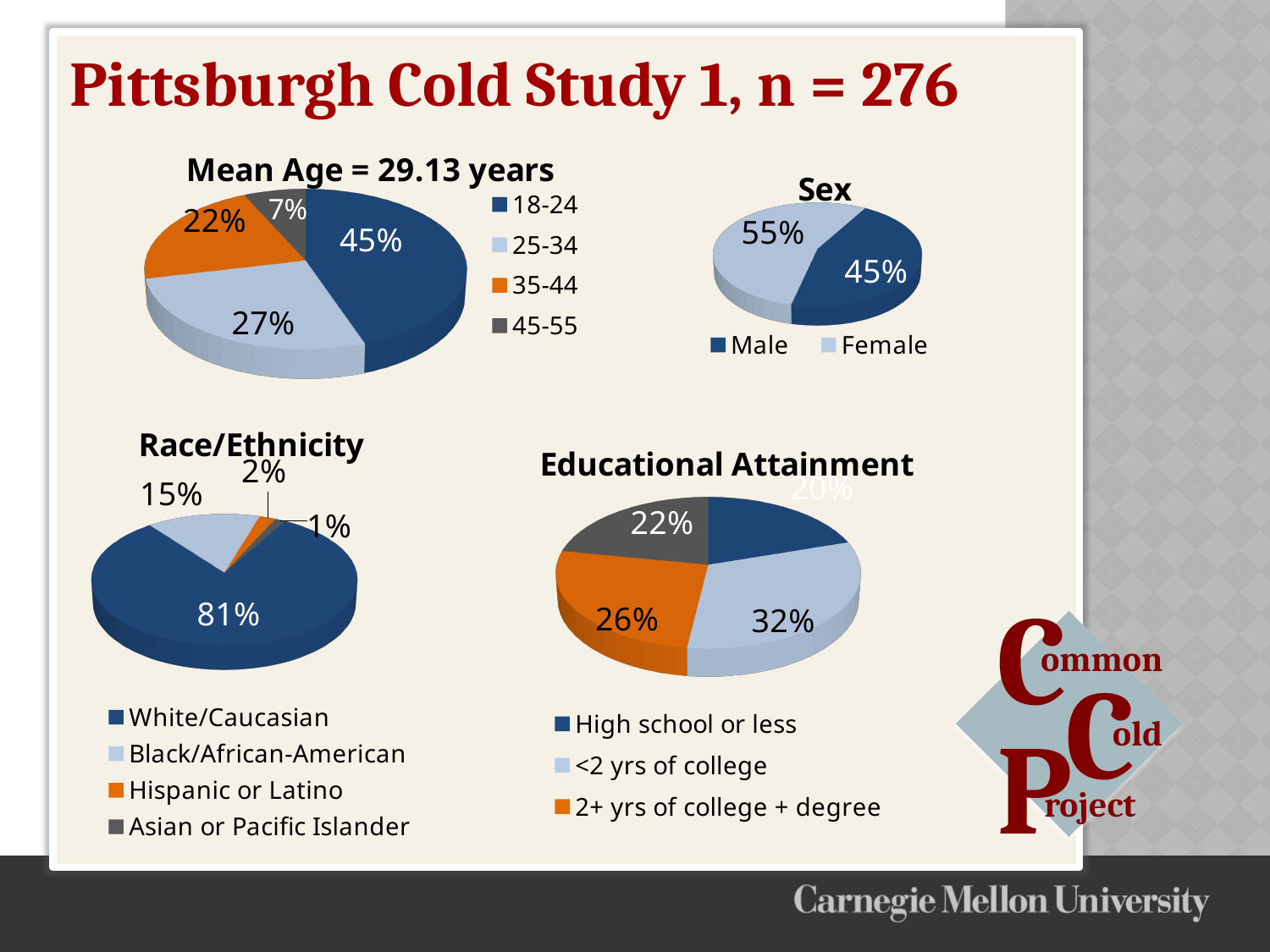
What type of chart is the Sex chart? Pie chart In the Educational Attainment chart, what percentage of participants have <2 yrs of college? 32% In the Sex chart, which is larger, the Male share or the Female share? Female In the Race/Ethnicity chart, what percentage of participants are White/Caucasian? 81% In the Race/Ethnicity chart, which group has the smallest share? Asian or Pacific Islander In the Mean Age = 29.13 years chart, what percentage of participants are aged 18-24? 45% In the Mean Age = 29.13 years chart, what percentage of participants are aged 45-55? 7% In the Mean Age = 29.13 years chart, which age group has the largest share? 18-24 How many categories does the legend of the Race/Ethnicity chart list? 4 In the Sex chart, what percentage of participants are female? 55% In the Educational Attainment chart, what percentage of participants have 2+ yrs of college + degree? 26% In the Mean Age = 29.13 years chart, what is the difference between the 25-34 and 35-44 shares? 5%